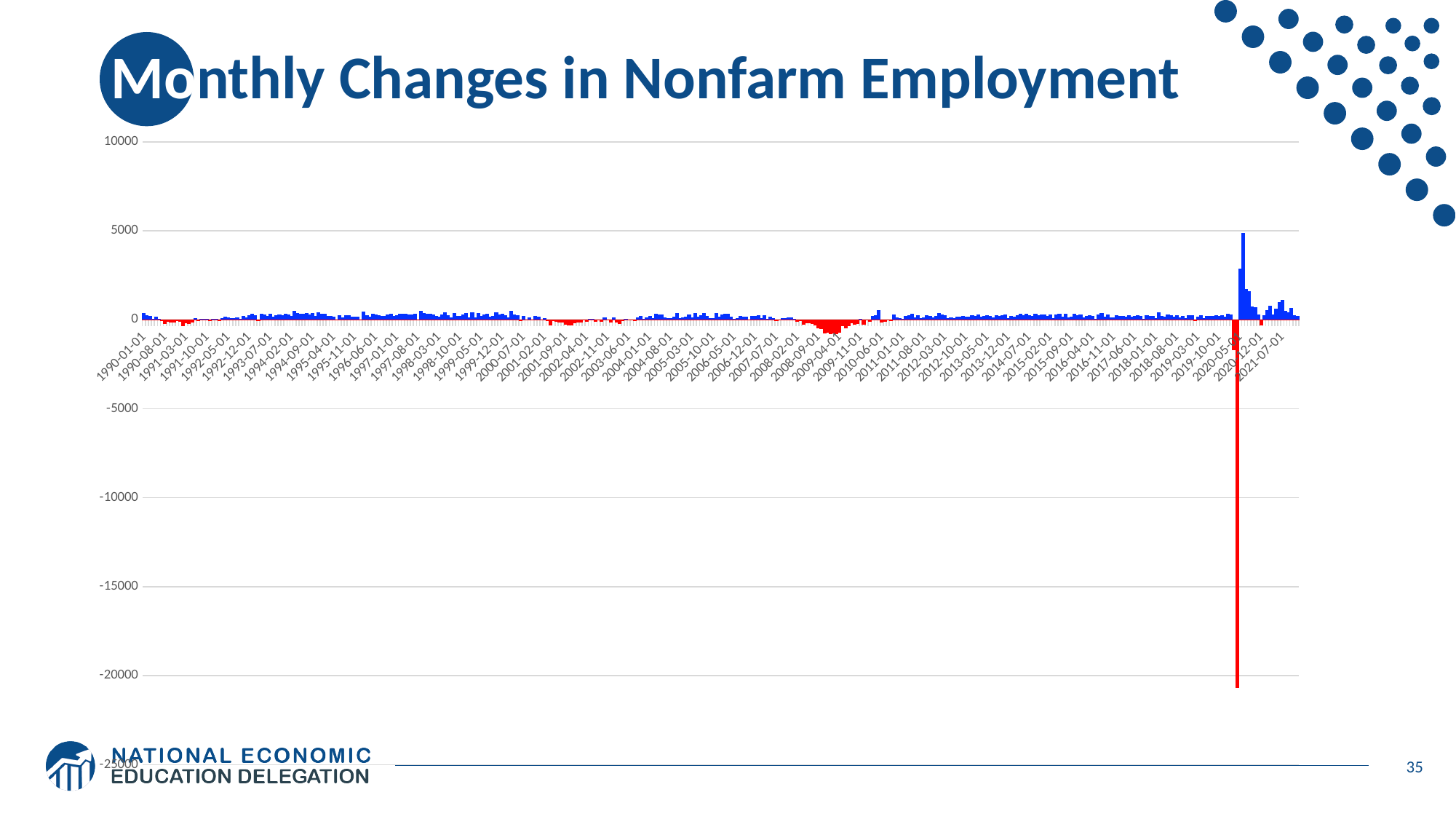
In which year does the lowest value in the chart occur? 2020 What is the title of the chart? Monthly Changes in Nonfarm Employment What is the lowest tick value shown on the vertical axis? -25000 In which year does the highest value in the chart occur? 2020 Which is larger in magnitude: the tallest blue bar in 2020 or the tall red bar in 2020? the tall red bar Is the value of the tallest blue bar (in 2020) greater or less than 0? greater What kind of chart is shown on the slide? bar chart What colour are the bars with negative values in the chart? red Are the bars around 2008-2009 mostly positive or negative? negative What is the highest tick value shown on the vertical axis? 10000 Is the value of the largest negative bar (the tall red bar in 2020) greater or less than -20000? less